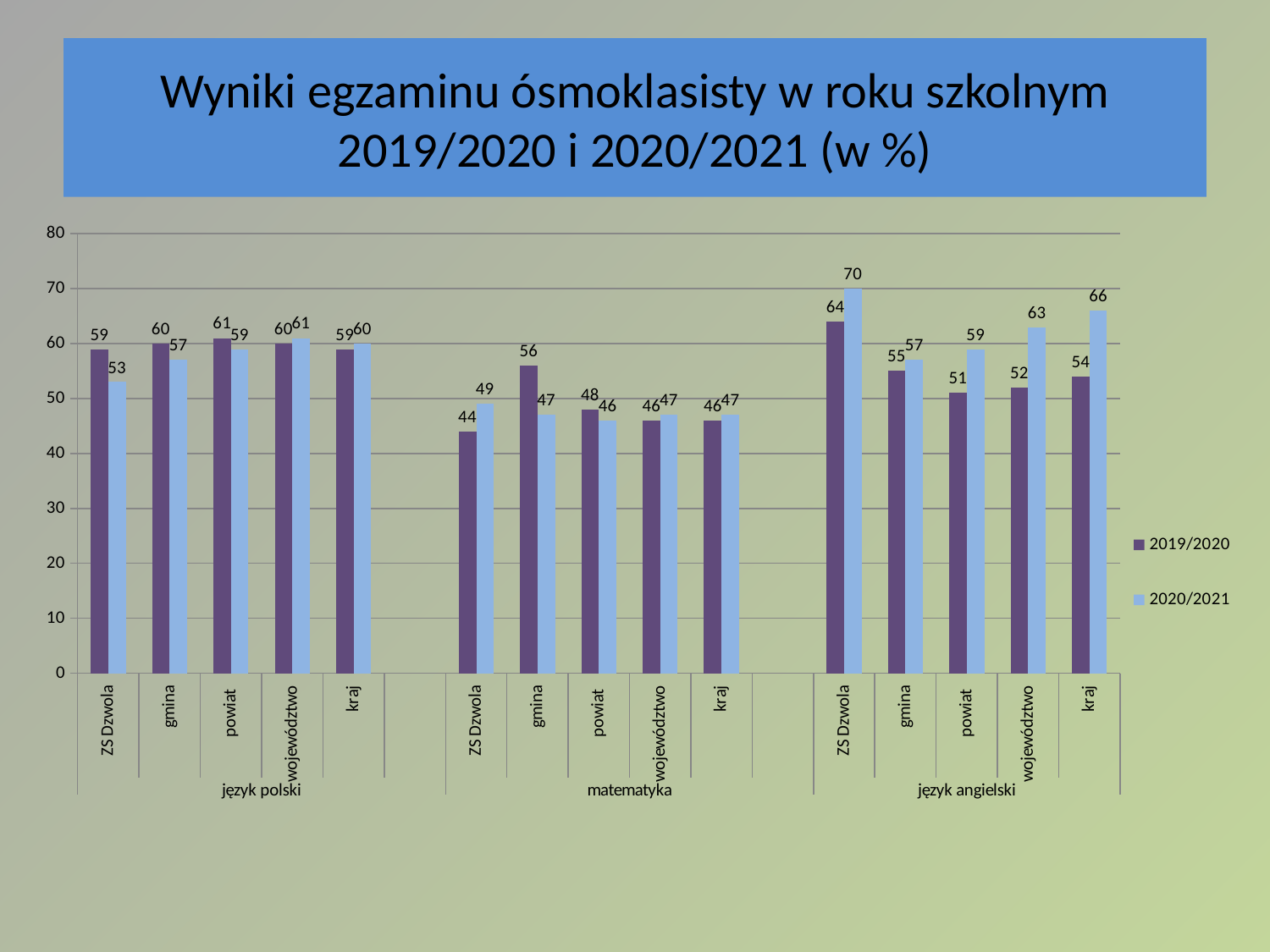
What is the 2020/2021 value for ZS Dzwola in język angielski? 70 How many subject groups are shown on the x axis? 3 What is the difference between the 2020/2021 and 2019/2020 values for kraj in język angielski? 12 What kind of chart is shown on the slide? bar chart Is the 2020/2021 value for województwo in język angielski greater or less than 60? greater Which category has the highest 2020/2021 value in the whole chart? ZS Dzwola (język angielski) How many series does the legend list? 2 What is the 2019/2020 value for gmina in matematyka? 56 What is the 2019/2020 value for ZS Dzwola in język polski? 59 For ZS Dzwola in język polski, which is larger: the 2019/2020 value or the 2020/2021 value? 2019/2020 What is the title of the chart? Wyniki egzaminu ósmoklasisty w roku szkolnym 2019/2020 i 2020/2021 (w %) Which category has the lowest 2019/2020 value in the whole chart? ZS Dzwola (matematyka)